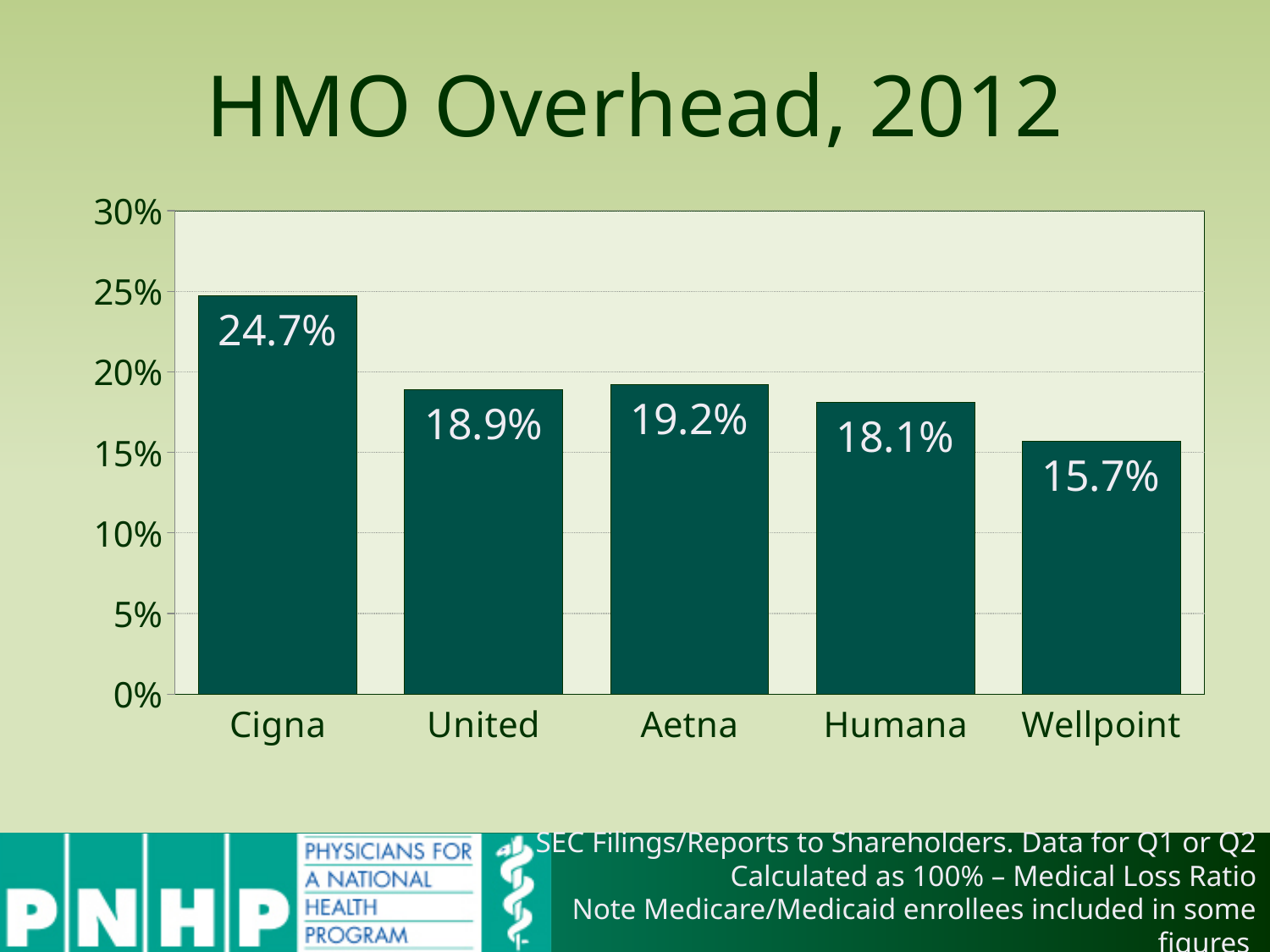
What is the difference between Cigna's and Wellpoint's overhead? 9.0% What is the overhead value for Cigna? 24.7% What kind of chart is shown on the slide? Bar chart What is the overhead value for Humana? 18.1% What is the overhead value for Wellpoint? 15.7% Which HMO has the lowest overhead? Wellpoint Is the value for Cigna greater or less than 20%? greater What is the title of the chart? HMO Overhead, 2012 Which has a higher overhead, United or Humana? United How many HMOs are shown in the chart? 5 Which HMO has the highest overhead? Cigna What is the difference between Aetna's and United's overhead? 0.3%